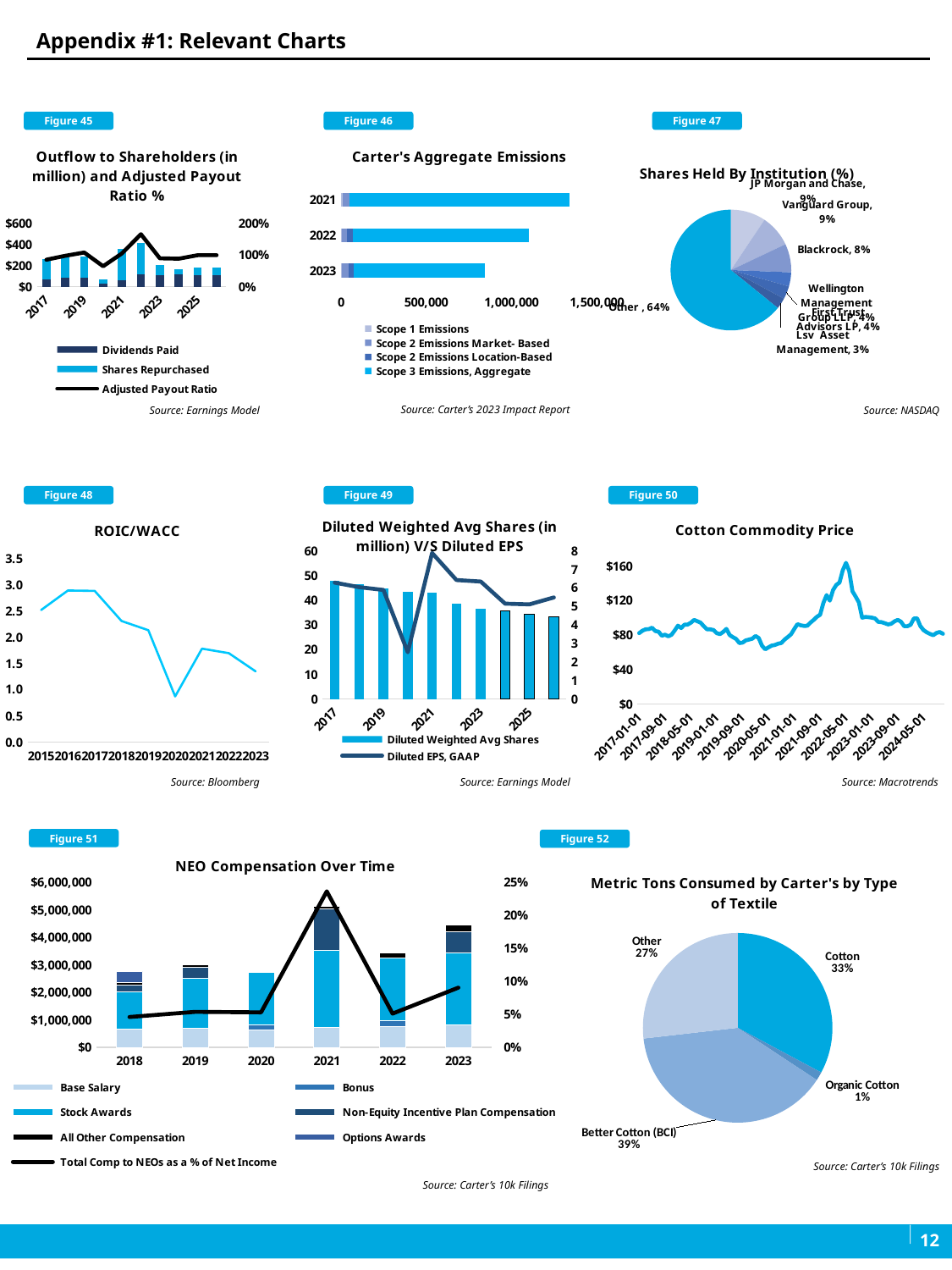
In the 'Metric Tons Consumed by Carter's by Type of Textile' pie chart, which textile type has the smallest share? Organic Cotton In the 'ROIC/WACC' chart, is the value for 2020 greater or less than 1.0? less In the 'Metric Tons Consumed by Carter's by Type of Textile' pie chart, how many percentage points larger is the Better Cotton (BCI) share than the Cotton share? 6 percentage points In the 'Shares Held By Institution (%)' pie chart, what share is held by Blackrock? 8% In the 'Shares Held By Institution (%)' pie chart, which slice is the largest? Other What kind of chart is 'Cotton Commodity Price'? Line chart How many series does the legend of the 'Carter's Aggregate Emissions' chart list? 4 In the 'ROIC/WACC' chart, which year has the lowest value? 2020 In the 'Metric Tons Consumed by Carter's by Type of Textile' pie chart, what share is Better Cotton (BCI)? 39% In the 'Carter's Aggregate Emissions' chart, is the total bar for 2023 greater or less than 1,000,000? less In the 'NEO Compensation Over Time' chart, which year has the tallest stacked bar? 2021 In the 'Carter's Aggregate Emissions' chart, which year has the longest bar? 2021